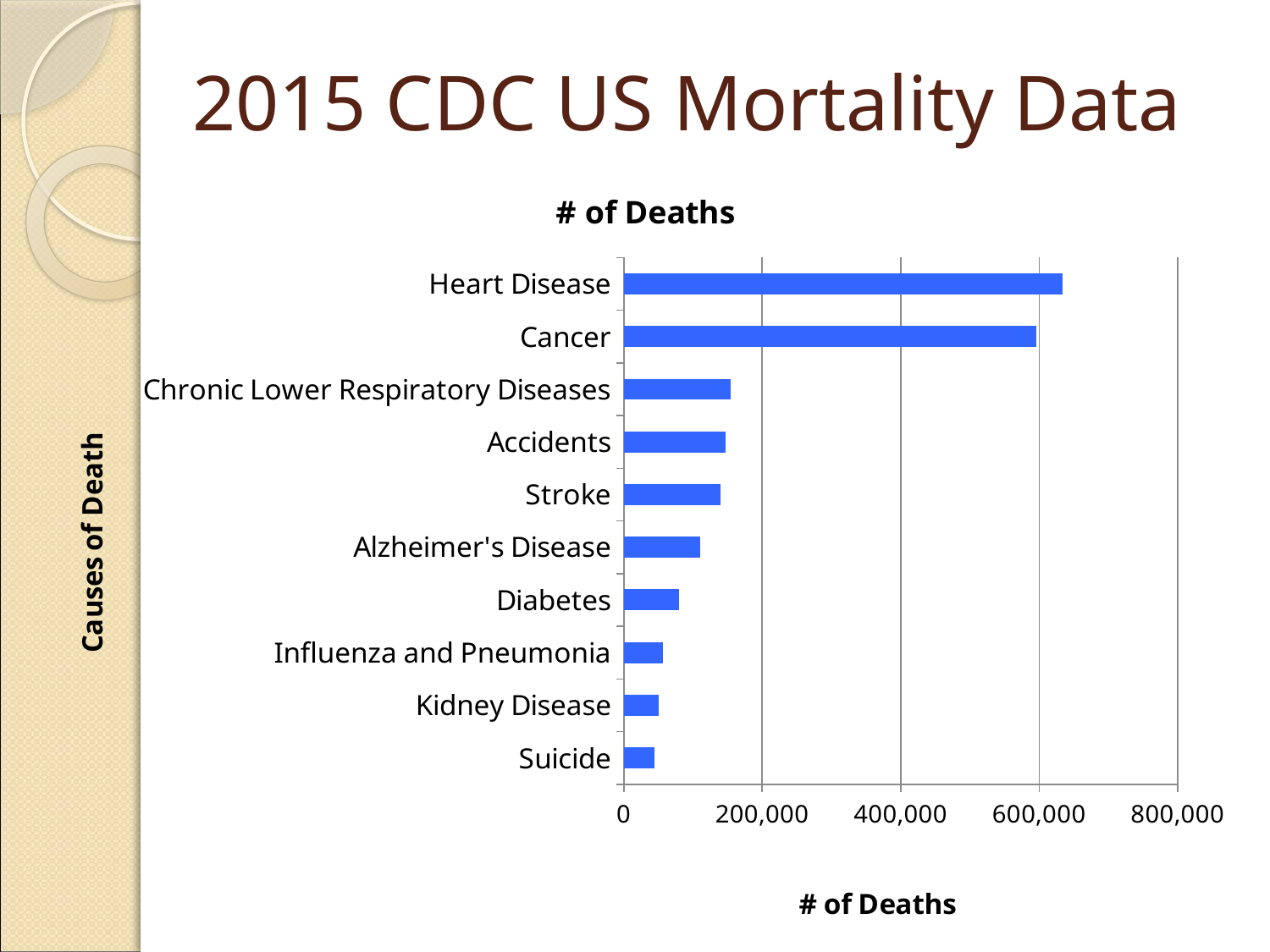
Is the value for Chronic Lower Respiratory Diseases greater or less than 200,000? less How many causes of death are plotted in the chart? 10 Is the value for Alzheimer's Disease greater or less than 200,000? less Which has more deaths, Heart Disease or Cancer? Heart Disease What is the title of the chart? # of Deaths Which cause of death has the highest number of deaths? Heart Disease Which has more deaths, Stroke or Alzheimer's Disease? Stroke Which has more deaths, Diabetes or Suicide? Diabetes Is the value for Cancer greater or less than 400,000? greater What is the label on the vertical axis of the chart? Causes of Death What type of chart is shown on the slide? bar chart